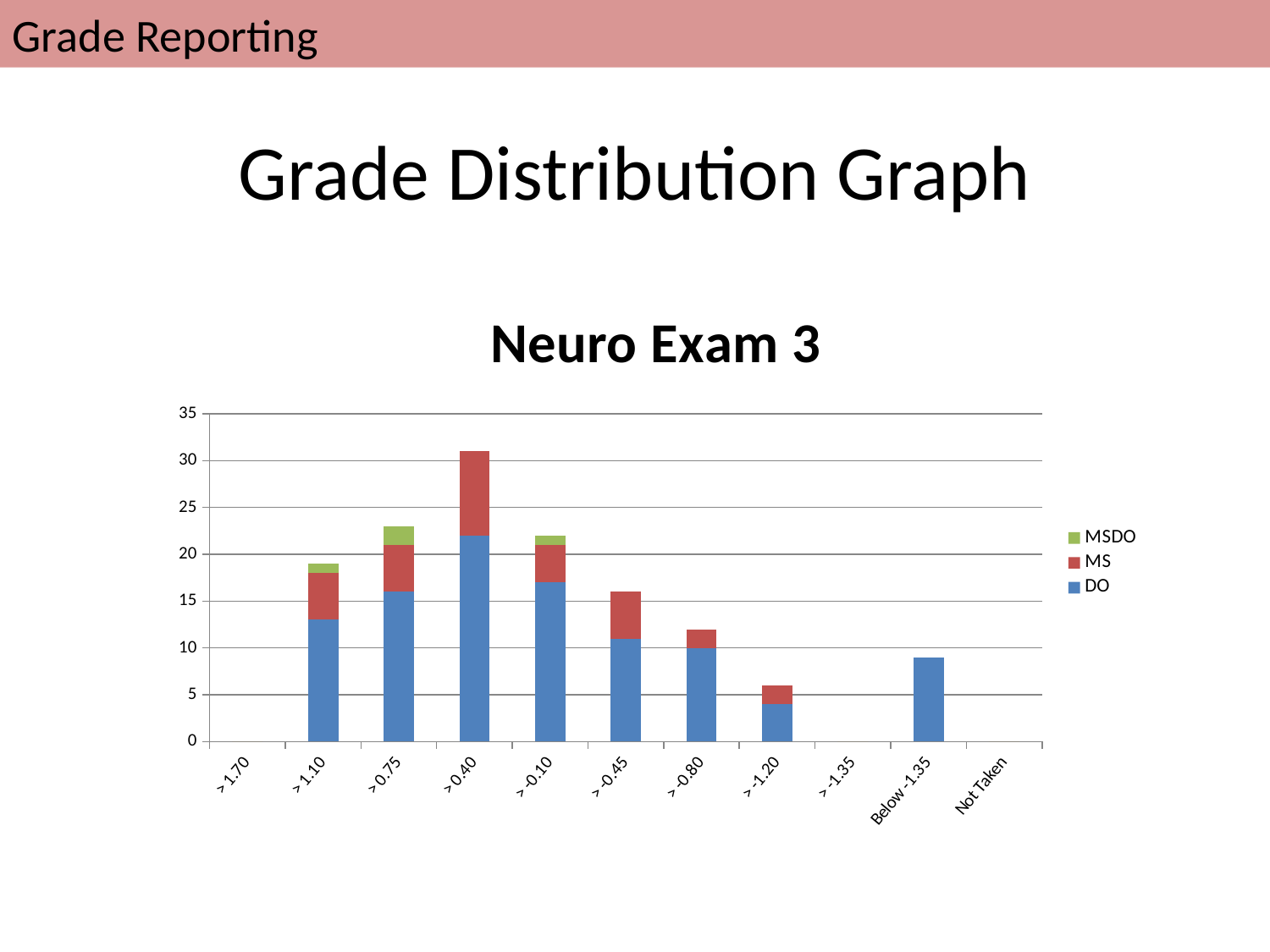
What type of chart is shown on the slide? Stacked bar chart How many categories are shown on the x axis? 11 Is the total stacked value for > 0.40 greater or less than 25? greater What is the title of the chart? Neuro Exam 3 How many series does the legend list? 3 Is the value for Below -1.35 greater or less than 15? less Which has the larger total stacked bar, > 0.75 or > -0.45? > 0.75 Which category has the tallest stacked bar? > 0.40 Is the total stacked value for > -1.20 greater or less than 10? less Do the stacked bar totals rise or fall from > 0.40 to > -1.20? fall Which series are listed in the legend? MSDO, MS, DO